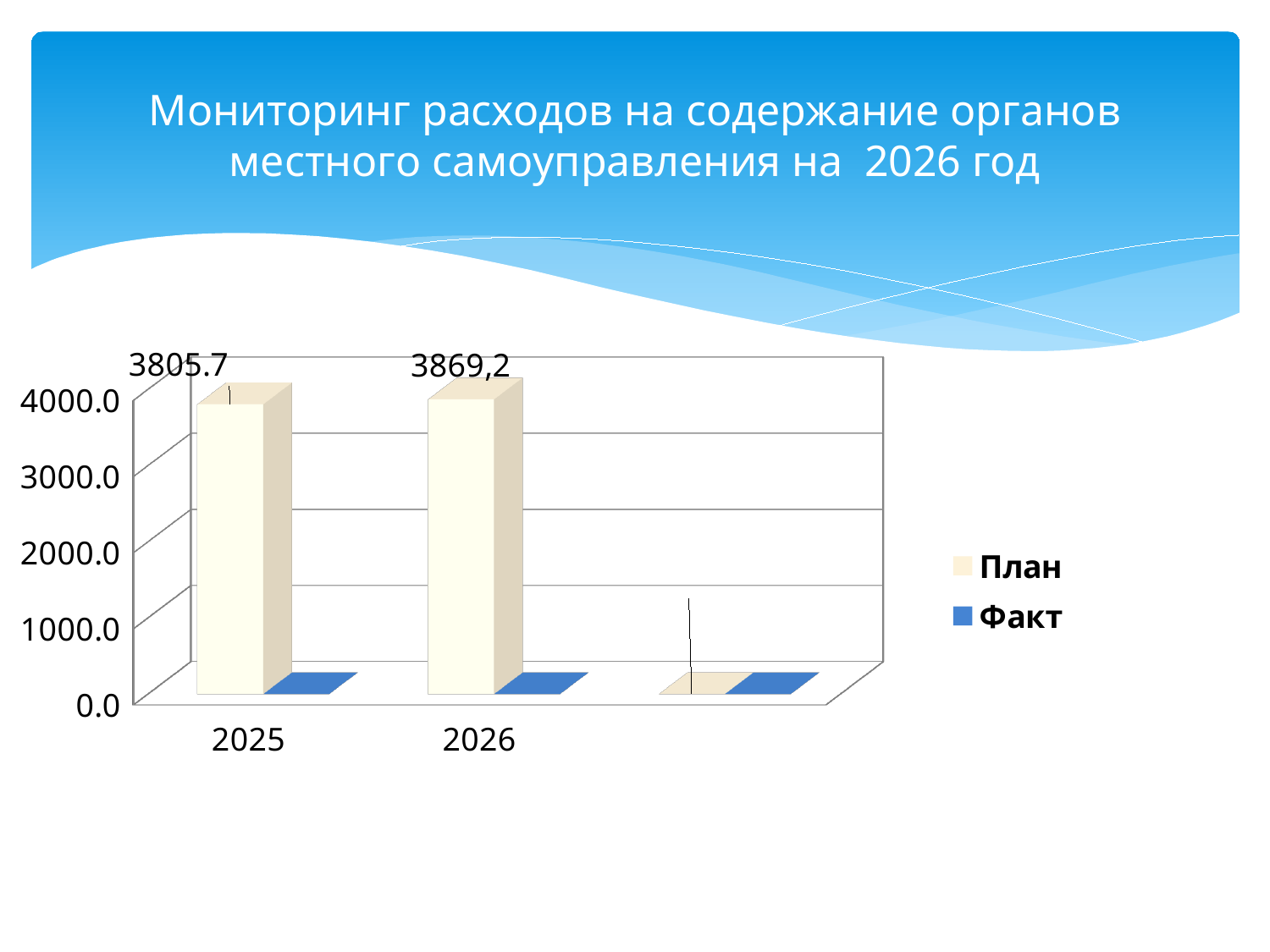
What are the two series named in the legend? План and Факт What kind of chart is shown on the slide? bar chart What is the План value for 2026? 3869,2 Which series is shown in blue in the legend? Факт How many series does the legend list? 2 Is the План value for 2025 greater or less than 3000.0? greater Which year has the higher План value, 2025 or 2026? 2026 What is the План value for 2025? 3805.7 Which year has the lowest План value among the labelled years? 2025 Is the План value for 2026 greater or less than 4000.0? less Does the План value rise or fall from 2025 to 2026? rise What is the difference between the План values for 2026 and 2025? 63.5